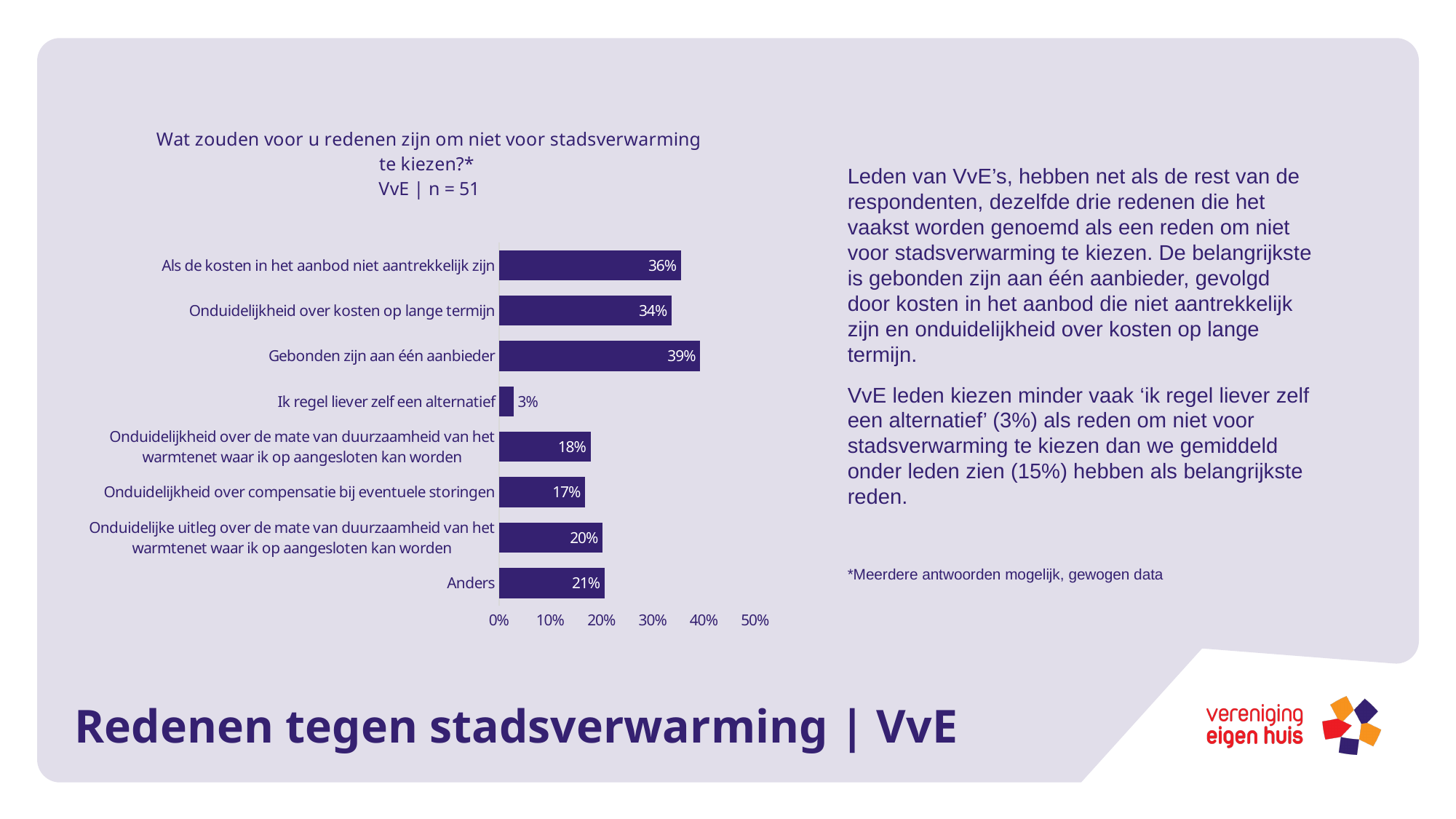
What is the value for 'Onduidelijkheid over compensatie bij eventuele storingen'? 17% Which category has the highest value? Gebonden zijn aan één aanbieder What is the value for 'Gebonden zijn aan één aanbieder'? 39% What kind of chart is shown on the slide? bar chart Is the value for 'Onduidelijke uitleg over de mate van duurzaamheid van het warmtenet waar ik op aangesloten kan worden' greater or less than 30%? less What is the difference between 'Als de kosten in het aanbod niet aantrekkelijk zijn' and 'Onduidelijkheid over kosten op lange termijn'? 2% What sample size (n) is stated in the chart title? n = 51 Which category has the lowest value? Ik regel liever zelf een alternatief What is the value for 'Anders'? 21% Which is larger: 'Anders' or 'Onduidelijkheid over compensatie bij eventuele storingen'? Anders How many categories are shown in the chart? 8 What is the value for 'Ik regel liever zelf een alternatief'? 3%